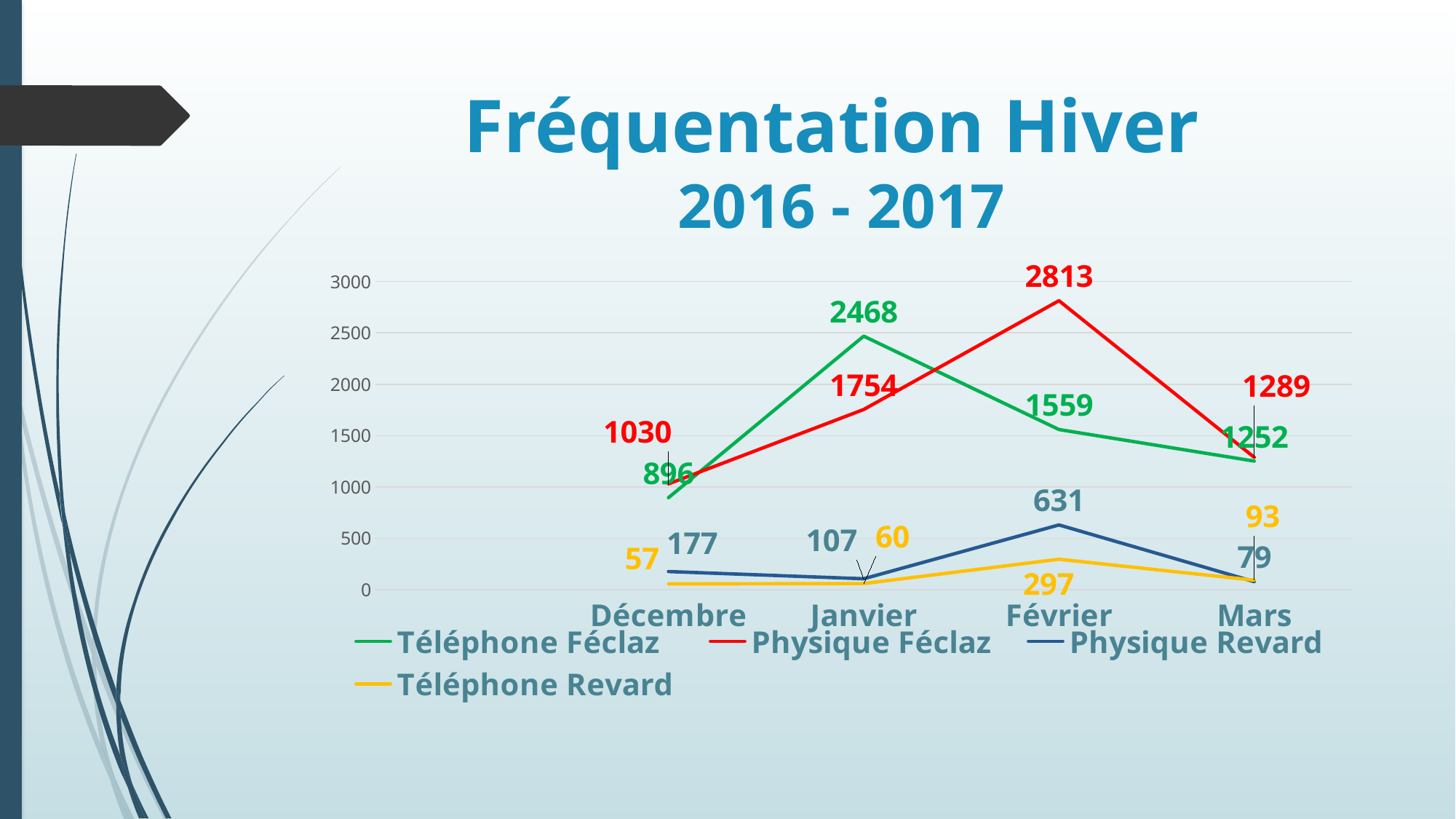
Does Physique Revard rise or fall from Février to Mars? fall How many months are plotted along the x axis? 4 What is the value for Téléphone Féclaz in Janvier? 2468 In which month is Physique Féclaz highest? Février What is the value for Physique Revard in Mars? 79 What kind of chart is shown on the slide? line chart How many series does the legend list? 4 What is the difference between Physique Féclaz and Téléphone Féclaz in Février? 1254 Which is larger in Janvier, Téléphone Féclaz or Physique Féclaz? Téléphone Féclaz What is the value for Téléphone Revard in Février? 297 In which month is Téléphone Revard lowest? Décembre What is the value for Physique Féclaz in Février? 2813